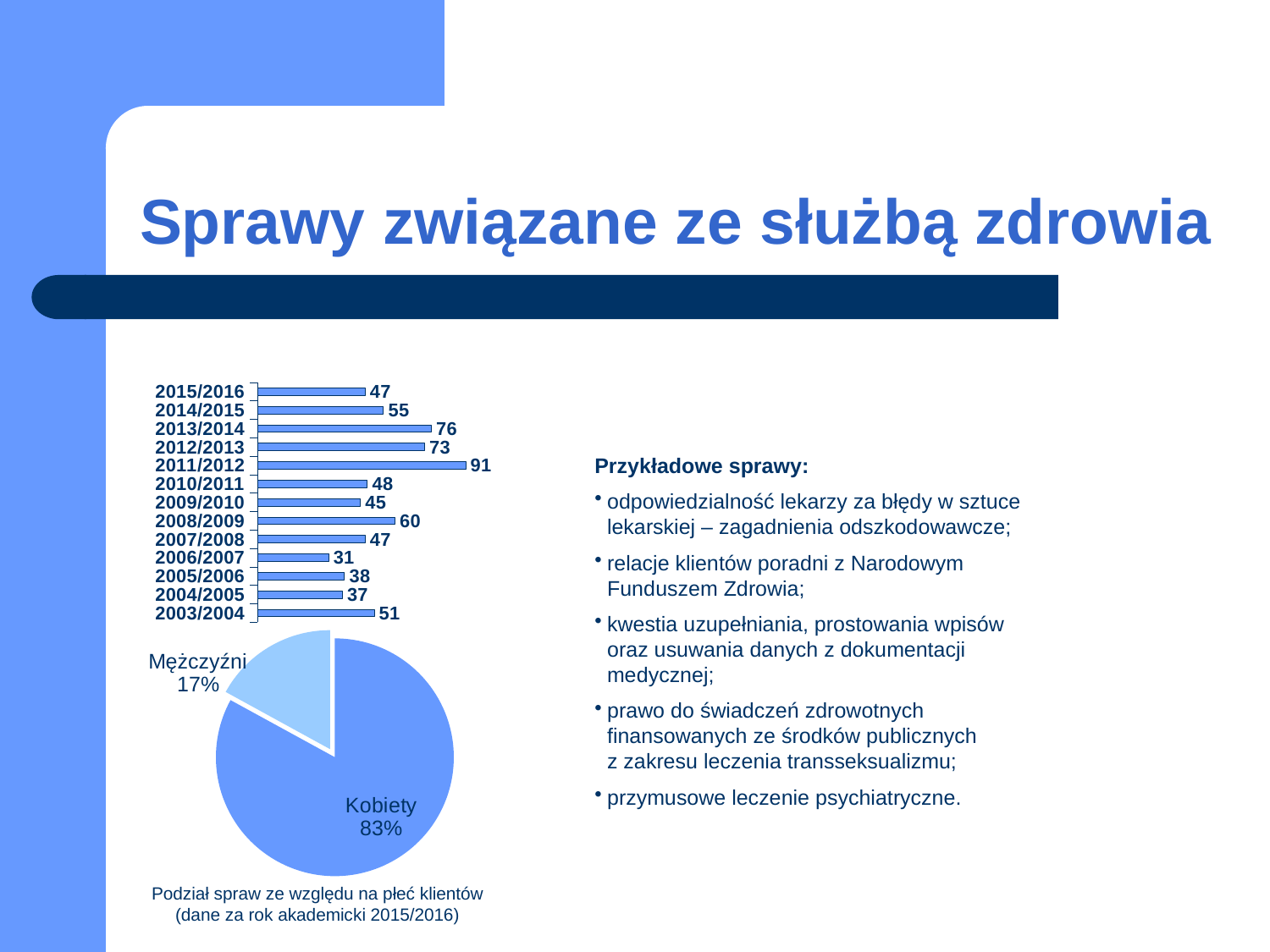
In the bar chart on the left, which academic year has the lowest value? 2006/2007 In the pie chart titled 'Podział spraw ze względu na płeć klientów', what share is Mężczyźni? 17% In the bar chart on the left, what is the difference between the values for 2013/2014 and 2012/2013? 3 In the pie chart titled 'Podział spraw ze względu na płeć klientów', what share is Kobiety? 83% In the bar chart on the left, what is the difference between the values for 2003/2004 and 2004/2005? 14 What kind of chart is the upper chart on the left? Bar chart In the pie chart titled 'Podział spraw ze względu na płeć klientów', how many slices are there? 2 In the bar chart on the left, what is the value for 2011/2012? 91 In the bar chart on the left, what is the value for 2015/2016? 47 In the bar chart on the left, which is larger: the value for 2008/2009 or the value for 2014/2015? 2008/2009 In the bar chart on the left, how many academic years are shown? 13 In the bar chart on the left, which academic year has the highest value? 2011/2012